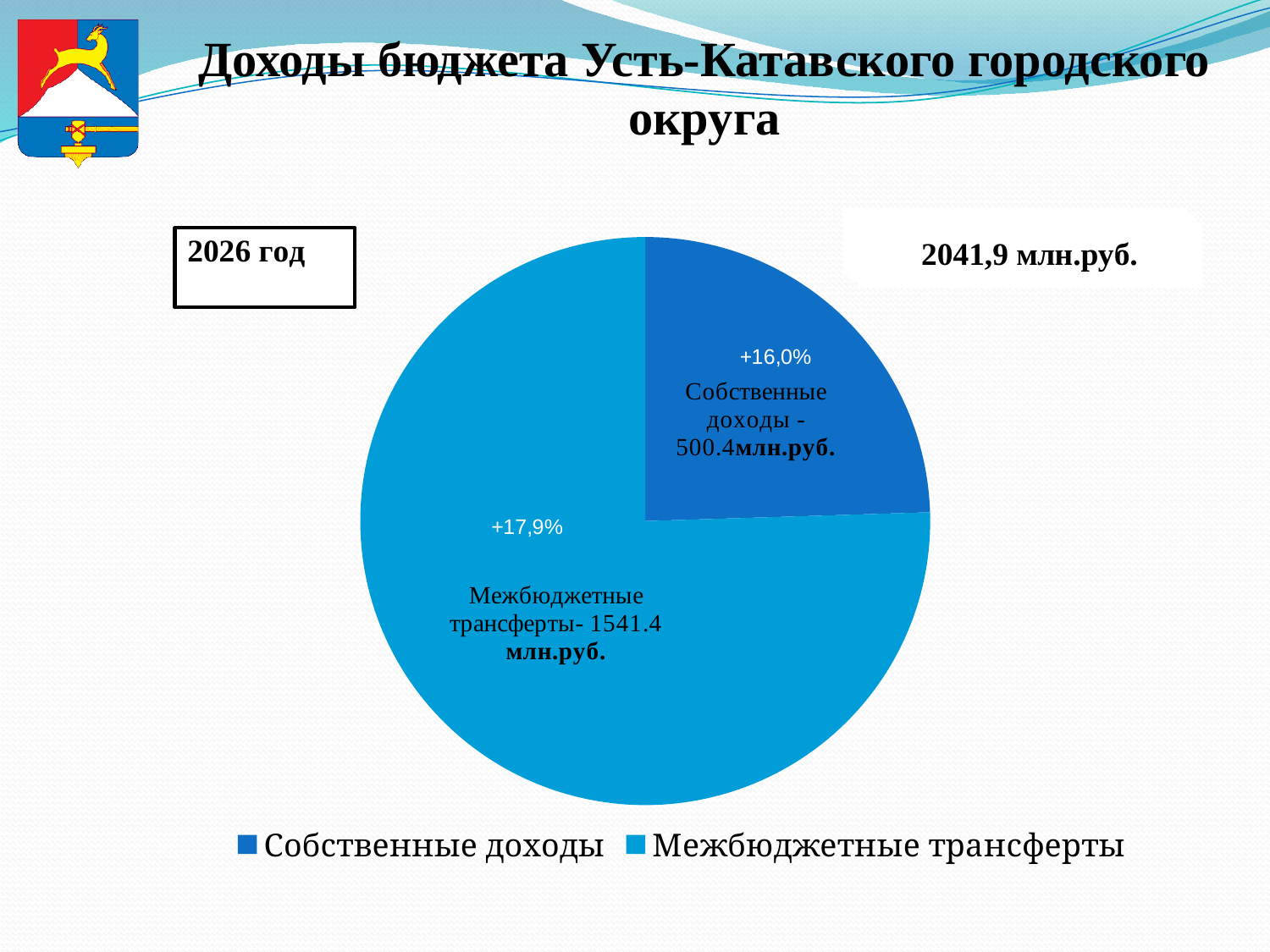
Which is larger, Собственные доходы or Межбюджетные трансферты? Межбюджетные трансферты What total budget revenue figure is shown on the slide for 2026? 2041,9 млн.руб. How many entries does the legend of the pie chart list? 2 How many slices does the pie chart have? 2 What kind of chart is shown on the slide? Pie chart What percentage change is shown next to the Межбюджетные трансферты slice? +17,9% Which slice of the pie chart is the largest? Межбюджетные трансферты Which slice of the pie chart is the smallest? Собственные доходы What is the difference between Межбюджетные трансферты and Собственные доходы in млн.руб.? 1041.0 млн.руб. What value is shown for Межбюджетные трансферты in the pie chart? 1541.4 млн.руб. What value is shown for Собственные доходы in the pie chart? 500.4 млн.руб. What percentage change is shown next to the Собственные доходы slice? +16,0%